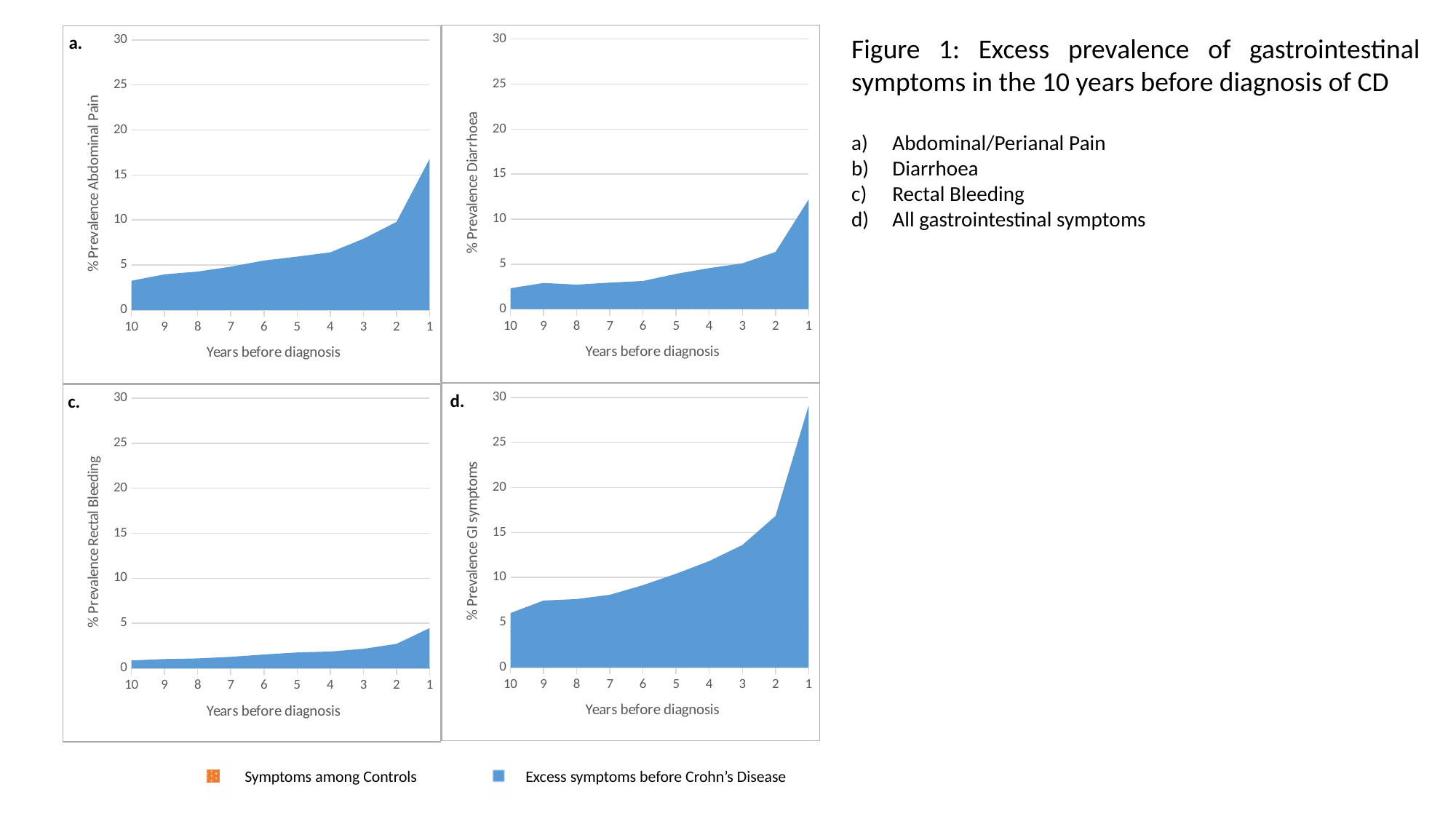
In chart a (% Prevalence Abdominal Pain), do the values rise or fall as the years before diagnosis go from 10 down to 1? rise How many points along the x axis (years before diagnosis) does chart c show? 10 What kind of chart is chart a (Abdominal Pain)? area chart In chart d (% Prevalence GI symptoms), at which number of years before diagnosis is the prevalence highest? 1 In chart a (% Prevalence Abdominal Pain), is the value at 1 year before diagnosis greater or less than 15? greater In chart c (% Prevalence Rectal Bleeding), is the value at 1 year before diagnosis greater or less than 5? less In chart a (% Prevalence Abdominal Pain), is the value at 10 years before diagnosis greater or less than 5? less In chart b (% Prevalence Diarrhoea), at which number of years before diagnosis is the prevalence lowest? 10 How many series does the legend at the bottom of the slide list? 2